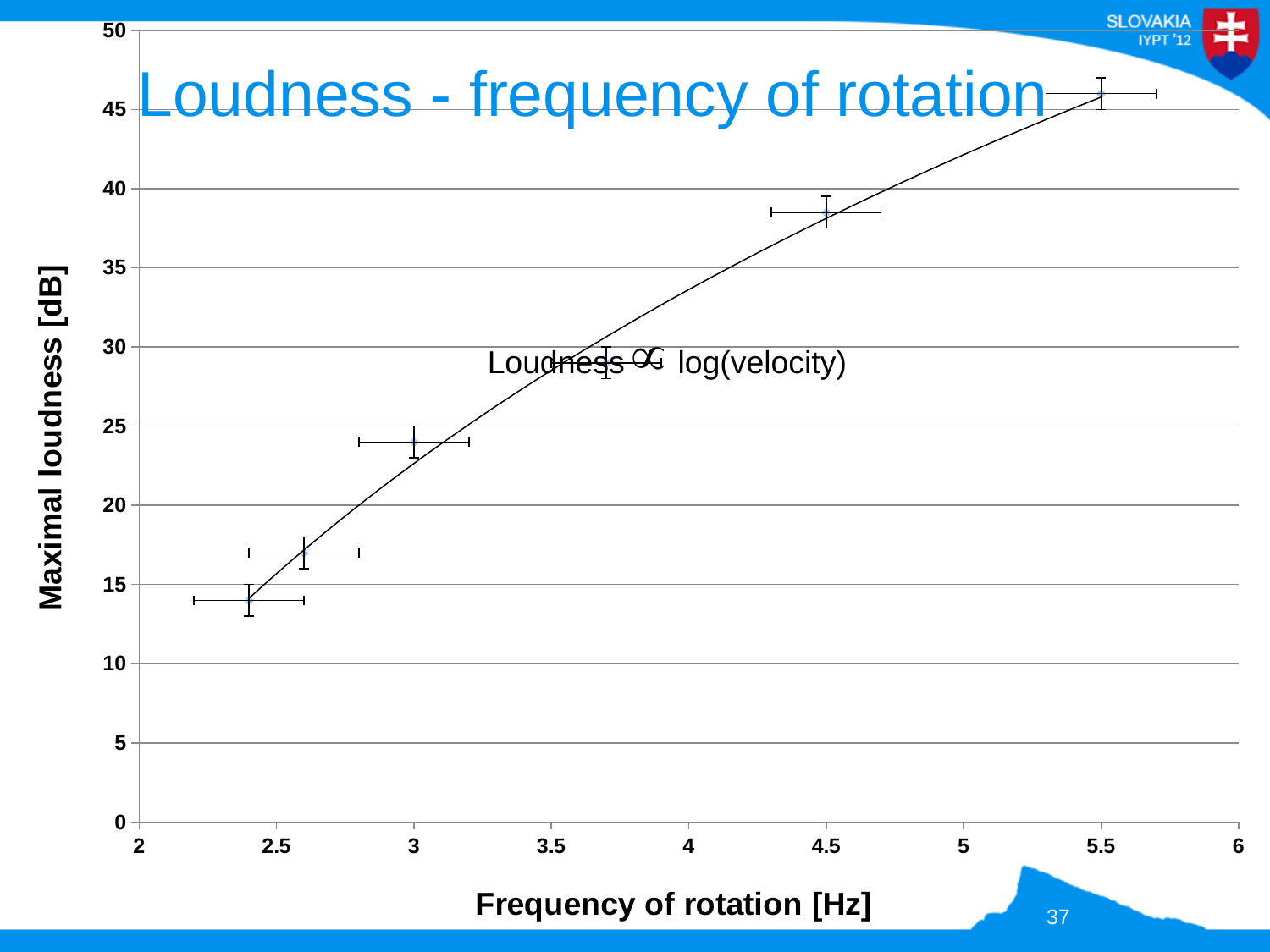
Is the maximal loudness for the point at 3 Hz greater or less than 20 dB? greater What is the label of the horizontal axis? Frequency of rotation [Hz] What kind of chart is shown on the slide? scatter chart Is the maximal loudness for the point at 4.5 Hz greater or less than 35 dB? greater Is the maximal loudness for the point at 4.5 Hz greater or less than 40 dB? less How many data points are plotted on the chart? 6 Does the maximal loudness rise or fall as the frequency of rotation increases? rise Which plotted point has the highest maximal loudness, the one at 5.5 Hz or the one at 2.4 Hz? 5.5 Hz What is the label of the vertical axis? Maximal loudness [dB]